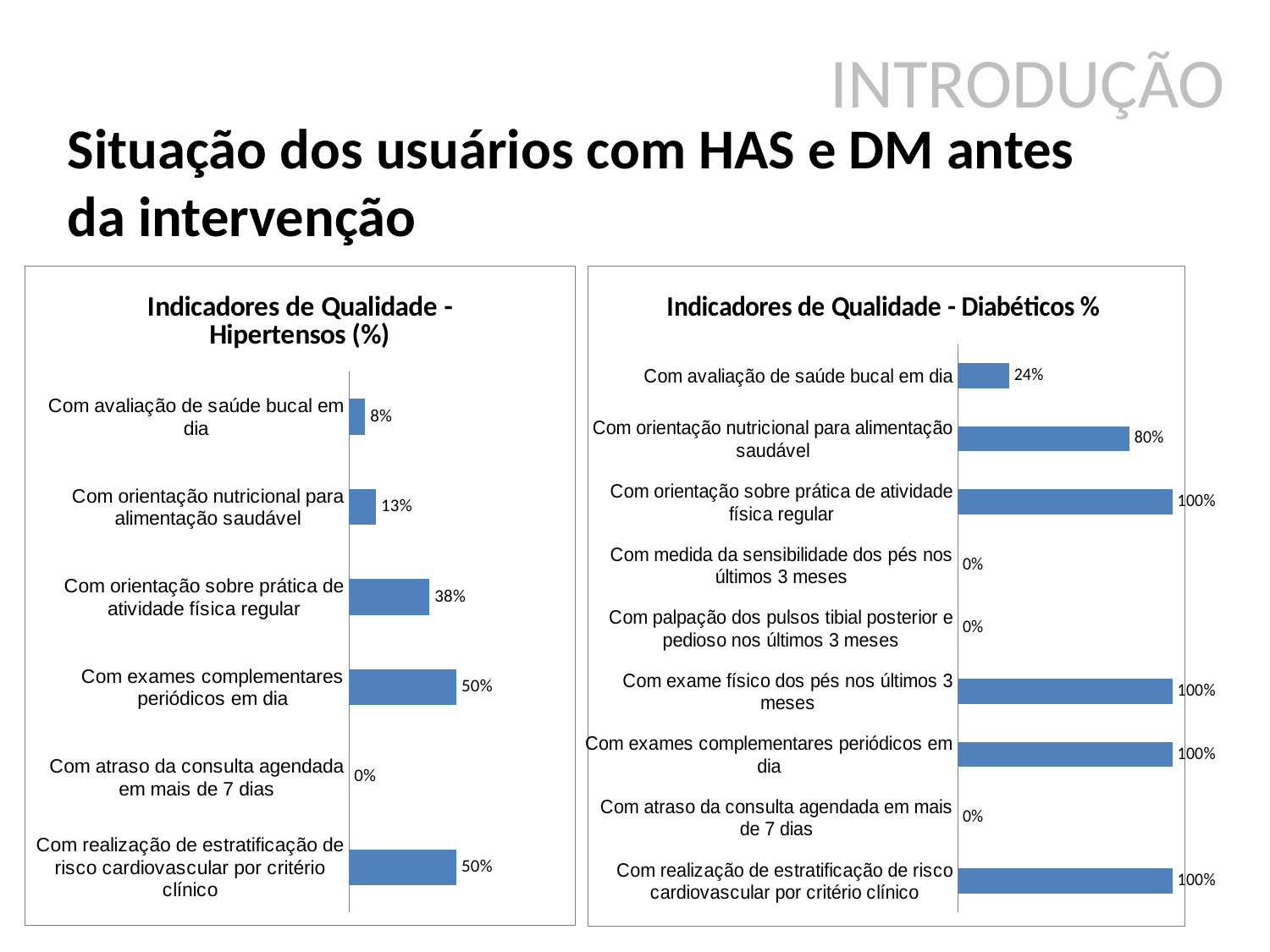
In the 'Indicadores de Qualidade - Hipertensos (%)' chart, what is the value for 'Com orientação sobre prática de atividade física regular'? 38% In the 'Indicadores de Qualidade - Diabéticos %' chart, how many categories are shown? 9 In the 'Indicadores de Qualidade - Hipertensos (%)' chart, what is the value for 'Com avaliação de saúde bucal em dia'? 8% In the 'Indicadores de Qualidade - Diabéticos %' chart, what is the difference between 'Com orientação sobre prática de atividade física regular' and 'Com avaliação de saúde bucal em dia'? 76% In the 'Indicadores de Qualidade - Hipertensos (%)' chart, how many categories are shown? 6 In the 'Indicadores de Qualidade - Hipertensos (%)' chart, what is the difference between 'Com exames complementares periódicos em dia' and 'Com orientação nutricional para alimentação saudável'? 37% In the 'Indicadores de Qualidade - Diabéticos %' chart, which is larger: 'Com avaliação de saúde bucal em dia' or 'Com orientação nutricional para alimentação saudável'? Com orientação nutricional para alimentação saudável In the 'Indicadores de Qualidade - Hipertensos (%)' chart, which category has the lowest value? Com atraso da consulta agendada em mais de 7 dias In the 'Indicadores de Qualidade - Diabéticos %' chart, what is the value for 'Com orientação nutricional para alimentação saudável'? 80% What type of chart is the 'Indicadores de Qualidade - Hipertensos (%)' chart? Bar chart In the 'Indicadores de Qualidade - Diabéticos %' chart, what is the value for 'Com medida da sensibilidade dos pés nos últimos 3 meses'? 0% In the 'Indicadores de Qualidade - Diabéticos %' chart, what is the value for 'Com avaliação de saúde bucal em dia'? 24%